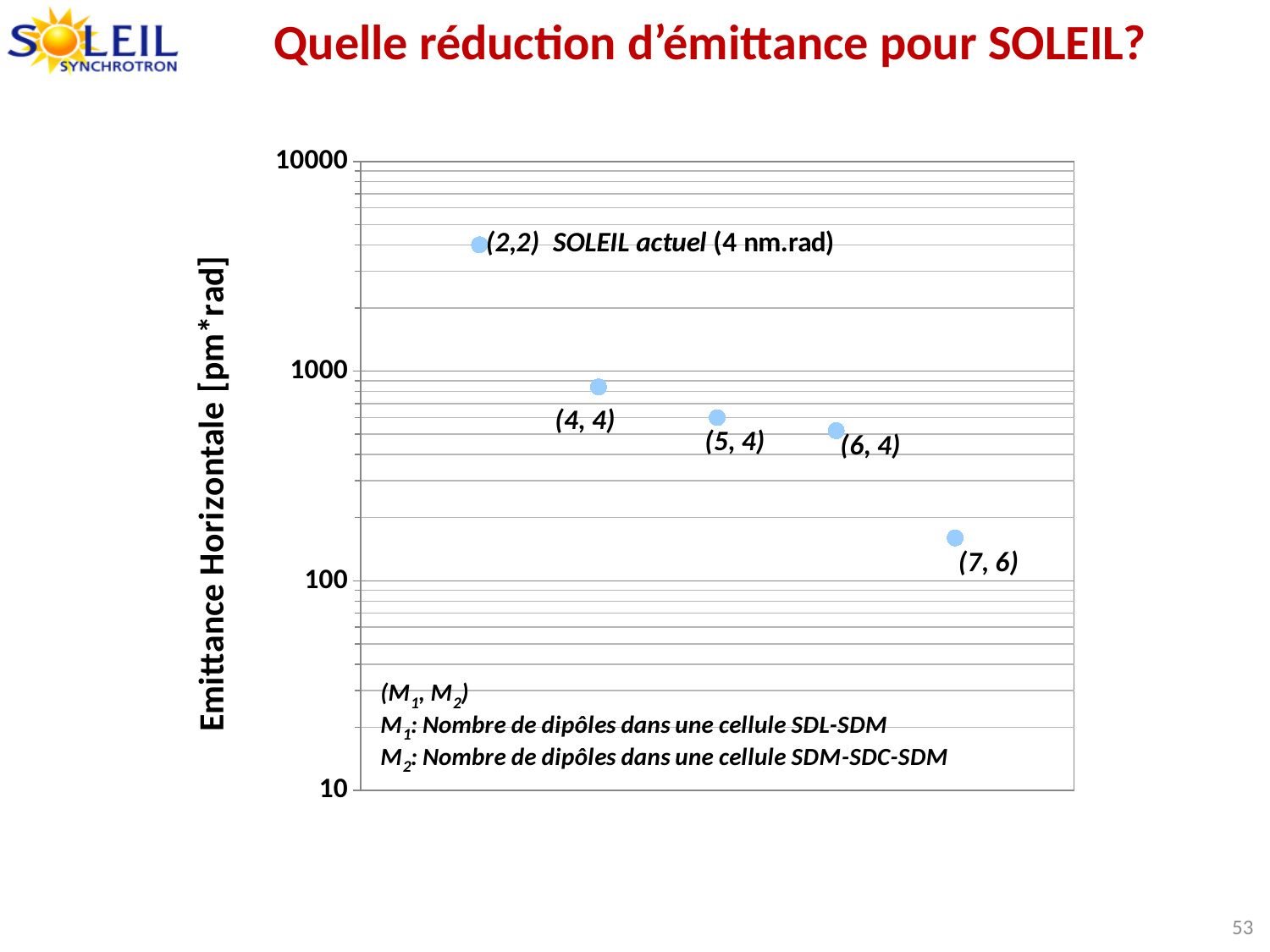
Is the value for (6, 4) greater or less than 1000? less Is the value for (4, 4) greater or less than 1000? less Is the value for (7, 6) greater or less than 100? greater What kind of chart is shown on the slide? scatter chart What is the label of the y axis? Emittance Horizontale [pm*rad] How many data points are plotted on the chart? 5 Do the emittance values rise or fall as you move from left to right across the chart? fall Which has the larger emittance, (4, 4) or (7, 6)? (4, 4) Which point has the lowest horizontal emittance? (7, 6) Which point has the highest horizontal emittance? (2,2) SOLEIL actuel What emittance value is printed next to the (2,2) SOLEIL actuel point? 4 nm.rad